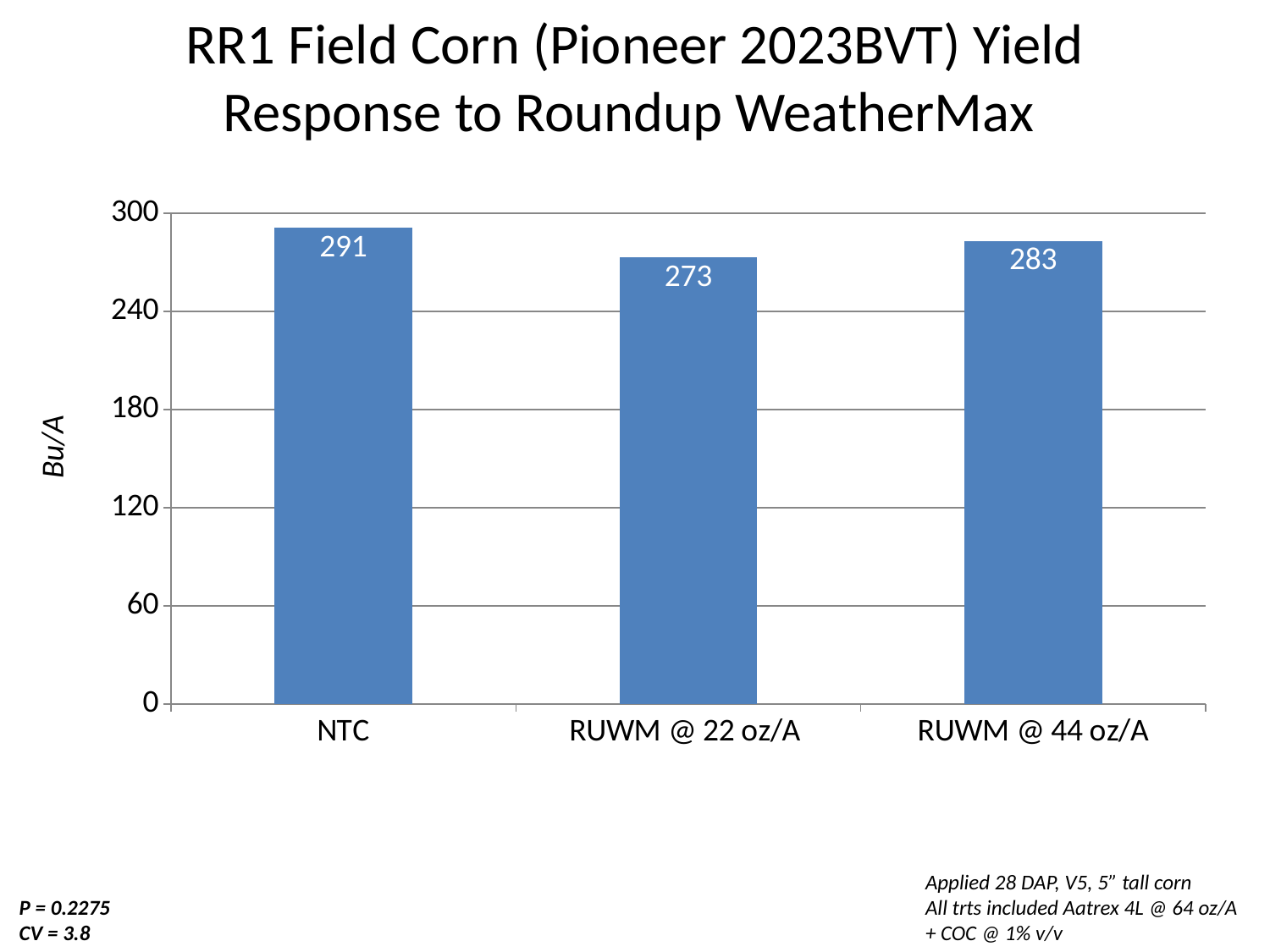
Which treatment has the highest yield? NTC What is the label on the vertical axis? Bu/A What is the yield for RUWM @ 44 oz/A? 283 Which treatment has the lowest yield? RUWM @ 22 oz/A How many treatments are shown on the chart? 3 What is the yield for RUWM @ 22 oz/A? 273 What is the yield for NTC? 291 What kind of chart is shown on the slide? bar chart Which has a higher yield, RUWM @ 22 oz/A or RUWM @ 44 oz/A? RUWM @ 44 oz/A What is the difference in yield between RUWM @ 44 oz/A and RUWM @ 22 oz/A? 10 What is the difference in yield between NTC and RUWM @ 22 oz/A? 18 Is the value for RUWM @ 22 oz/A greater or less than 240? greater